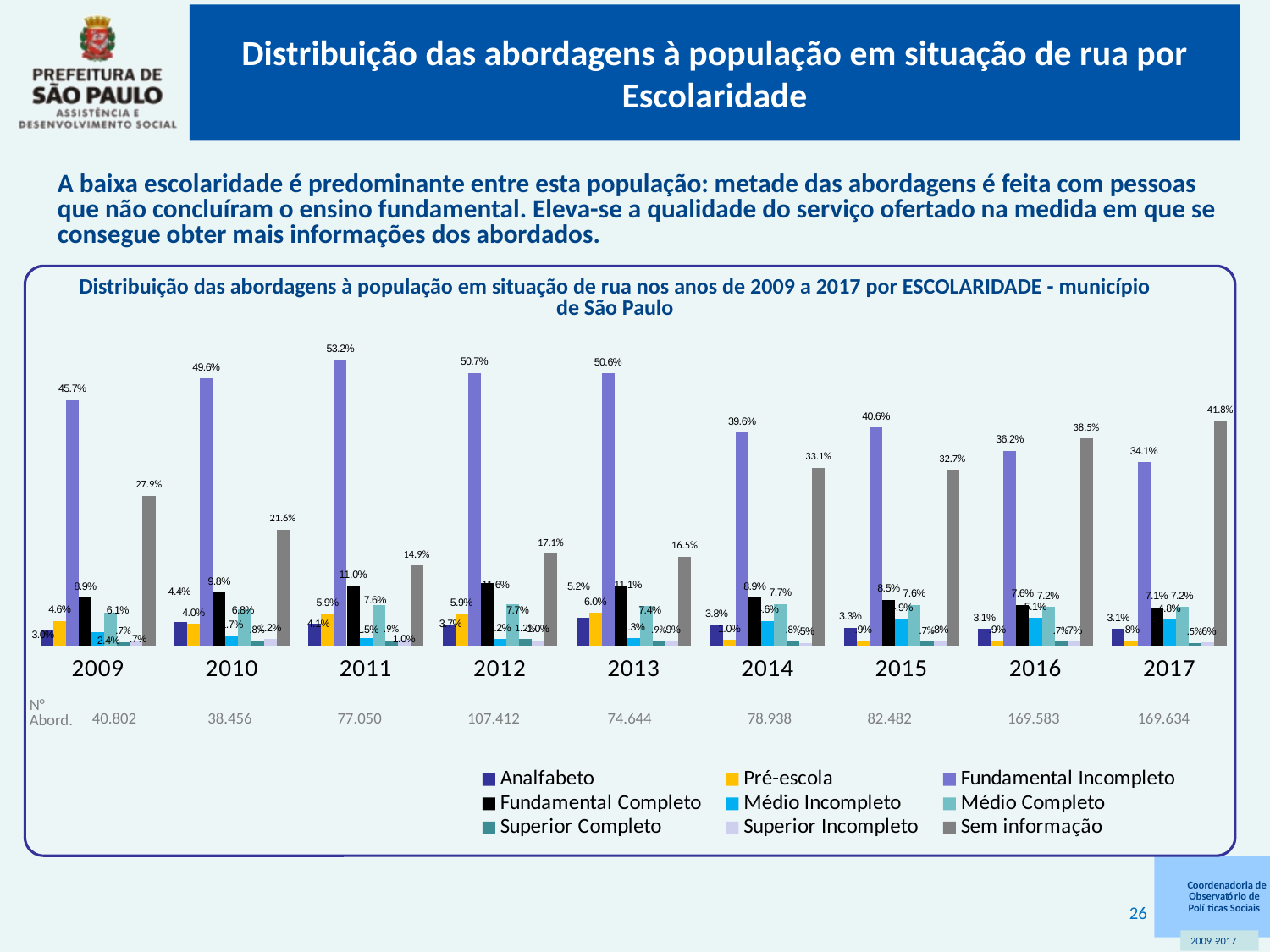
What is the value for Fundamental Incompleto in 2009? 45.7% In which year is the Sem informação value lowest? 2011 What is the value for Sem informação in 2017? 41.8% Does the Fundamental Incompleto value rise or fall from 2013 to 2017? fall How many series does the legend list? 9 What kind of chart is shown on the slide? bar chart What is the difference between the Fundamental Incompleto values in 2011 and 2017? 19.1% In 2017, which is larger: Fundamental Incompleto or Sem informação? Sem informação How many years are shown along the x axis of the chart? 9 In which year is the Fundamental Incompleto value highest? 2011 What is the value for Fundamental Incompleto in 2011? 53.2% What is the number of abordagens (Nº Abord.) shown for 2012? 107.412